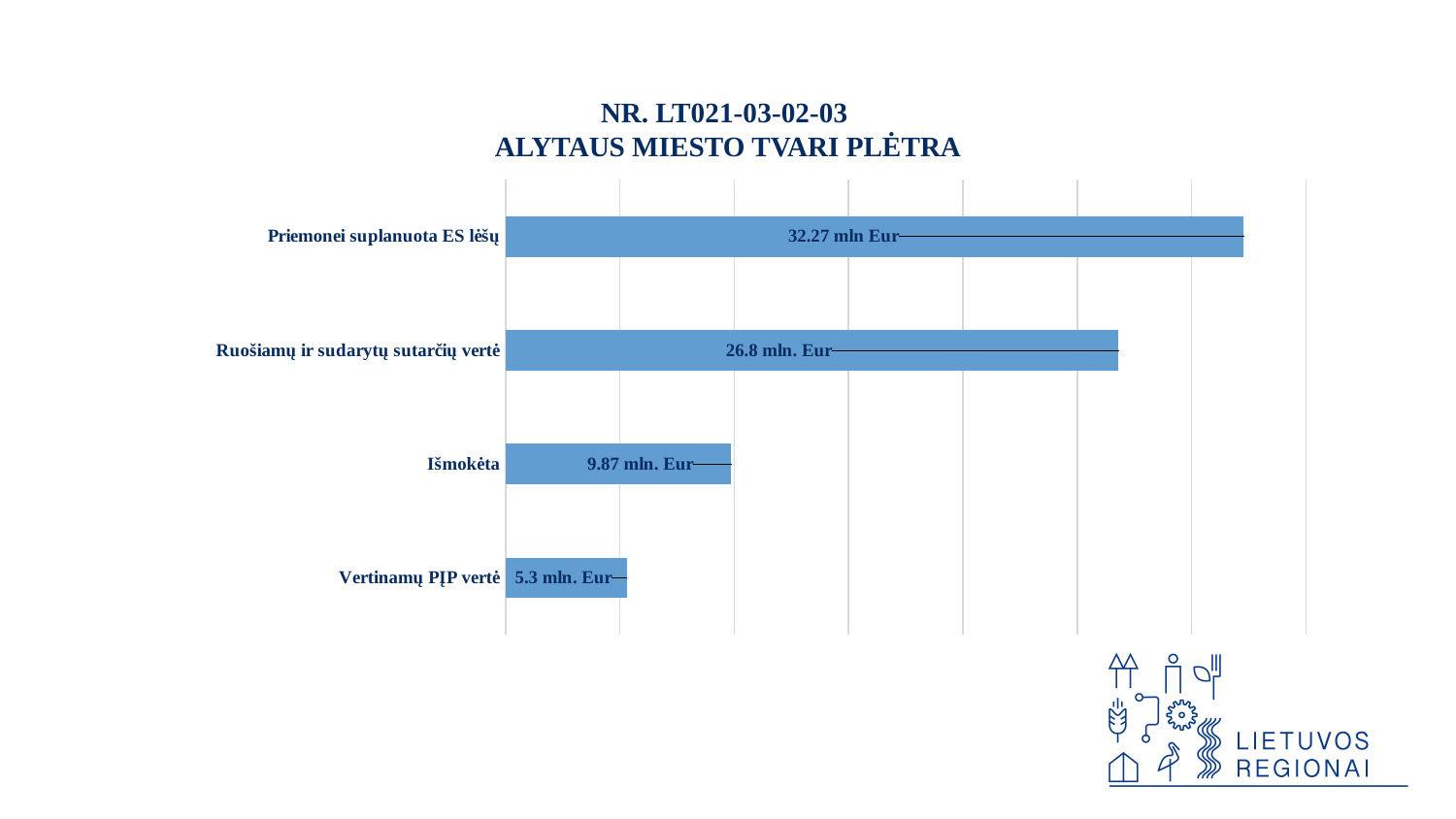
Which is larger, "Išmokėta" or "Vertinamų PĮP vertė"? Išmokėta What is the value for "Išmokėta"? 9.87 mln. Eur What is the value for "Priemonei suplanuota ES lėšų"? 32.27 mln Eur Which category has the lowest value? Vertinamų PĮP vertė What is the difference between "Priemonei suplanuota ES lėšų" and "Ruošiamų ir sudarytų sutarčių vertė"? 5.47 mln Eur What is the value for "Ruošiamų ir sudarytų sutarčių vertė"? 26.8 mln. Eur What is the difference between "Išmokėta" and "Vertinamų PĮP vertė"? 4.57 mln. Eur What is the title of the chart? NR. LT021-03-02-03 ALYTAUS MIESTO TVARI PLĖTRA What is the value for "Vertinamų PĮP vertė"? 5.3 mln. Eur What kind of chart is shown on the slide? Bar chart How many categories are shown in the chart? 4 Which category has the highest value? Priemonei suplanuota ES lėšų